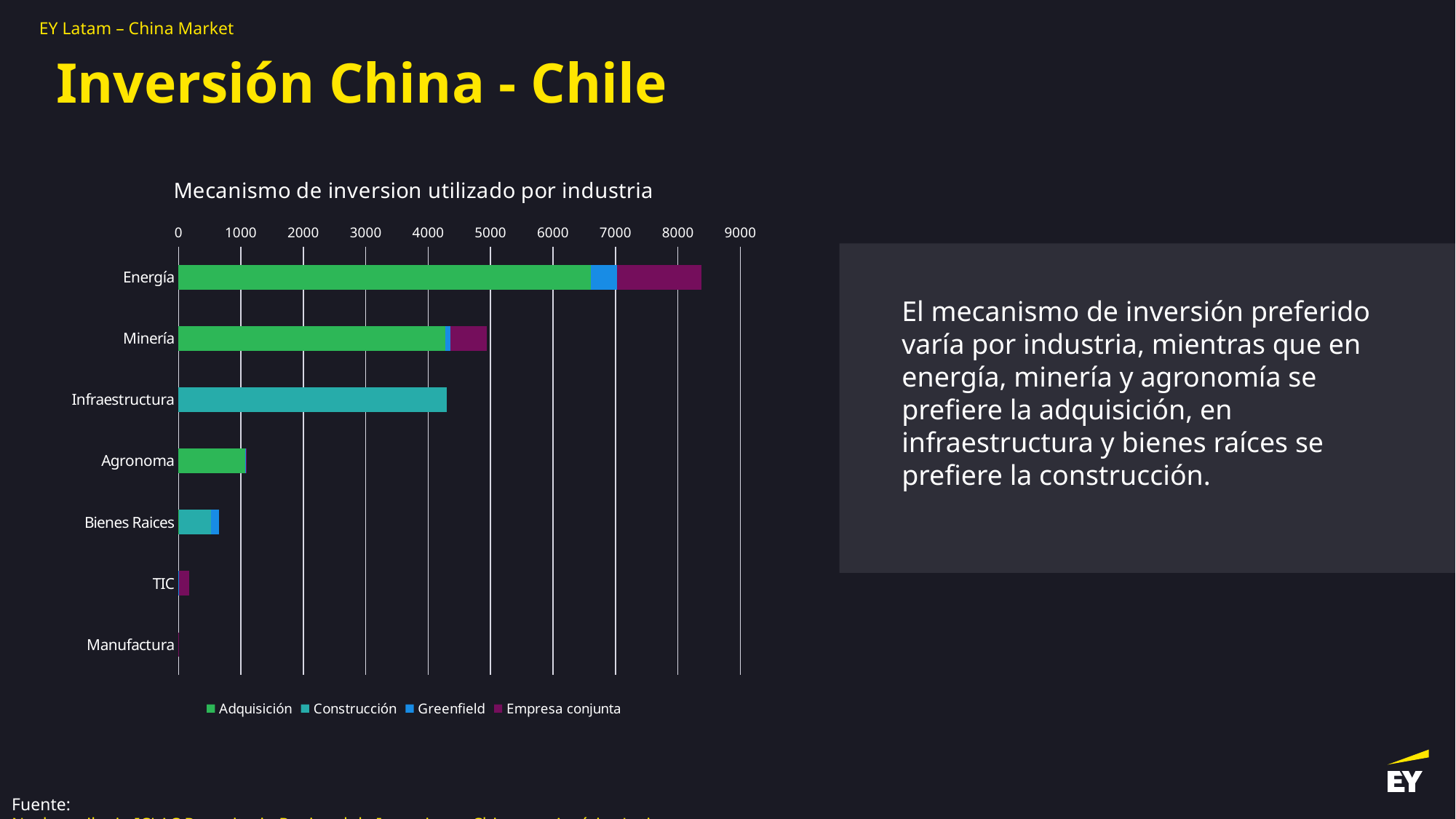
Is the total bar for Bienes Raices greater or less than 1000? less Which series is shown in the bar for Infraestructura? Construcción What is the title of the chart? Mecanismo de inversion utilizado por industria What kind of chart is shown on the slide? bar chart How many industry categories are shown on the chart? 7 Is the total bar for Energía greater or less than 8000? greater Which industry has the longest total bar? Energía How many series does the legend list? 4 Which industry has the smallest total bar? Manufactura Which has the larger total bar, Energía or Minería? Energía Is the bar for Infraestructura greater or less than 4000? greater